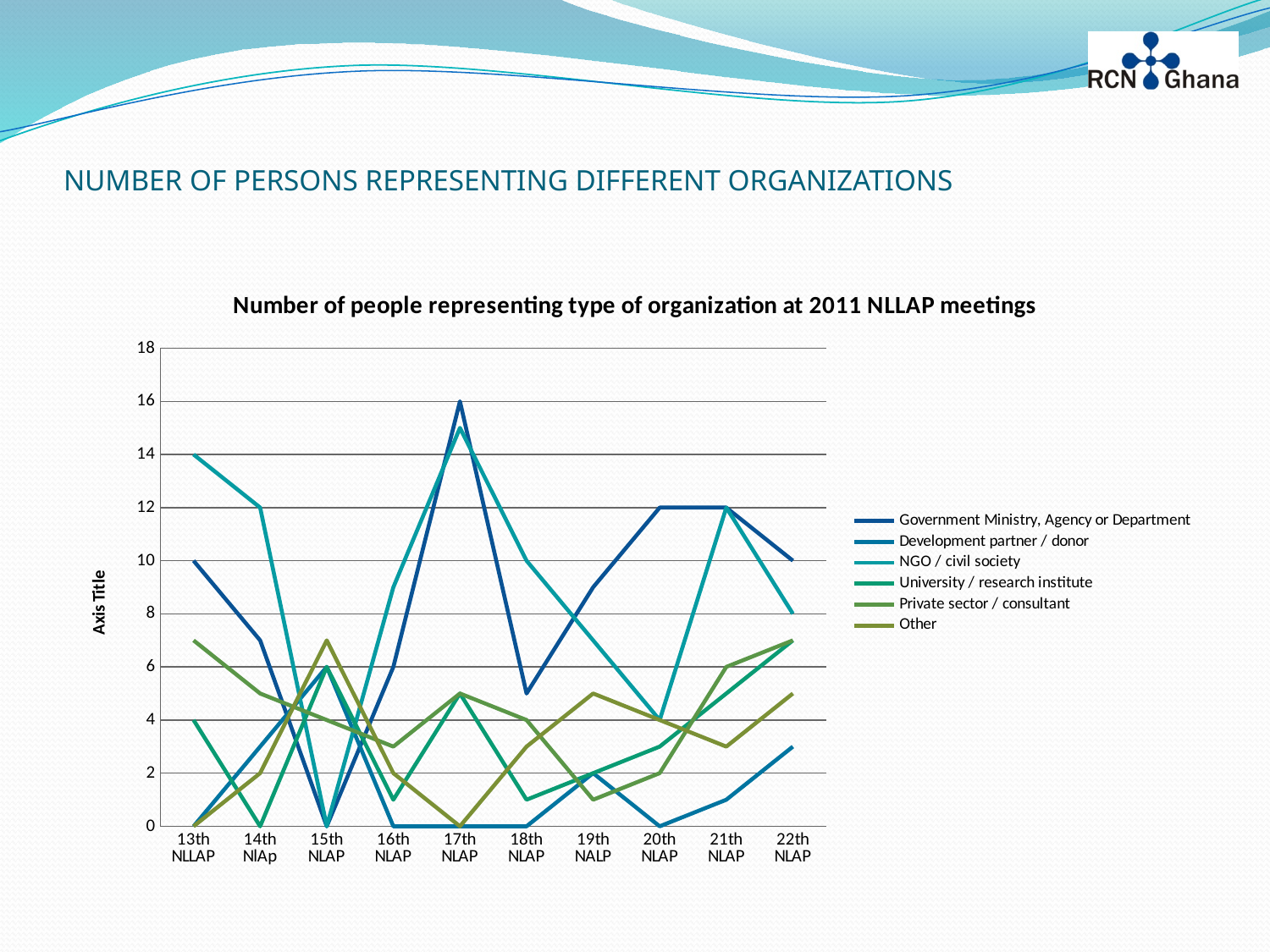
Is the value for Development partner / donor at the 22nd NLAP meeting greater or less than 4? less At which meeting does the Government Ministry, Agency or Department series reach its highest value? 17th NLAP What type of chart is shown on the slide? Line chart How many meetings are shown along the x axis? 10 What is the value for Government Ministry, Agency or Department at the 17th NLAP meeting? 16 At the 13th NLLAP meeting, which is larger: NGO / civil society or Government Ministry, Agency or Department? NGO / civil society Is the value for Government Ministry, Agency or Department at the 18th NLAP meeting greater or less than 6? less What is the title of the chart? Number of people representing type of organization at 2011 NLLAP meetings What label is shown on the vertical axis of the chart? Axis Title Is the value for NGO / civil society at the 17th NLAP meeting greater or less than 14? greater What is the value for NGO / civil society at the 13th NLLAP meeting? 14 How many series does the legend list? 6